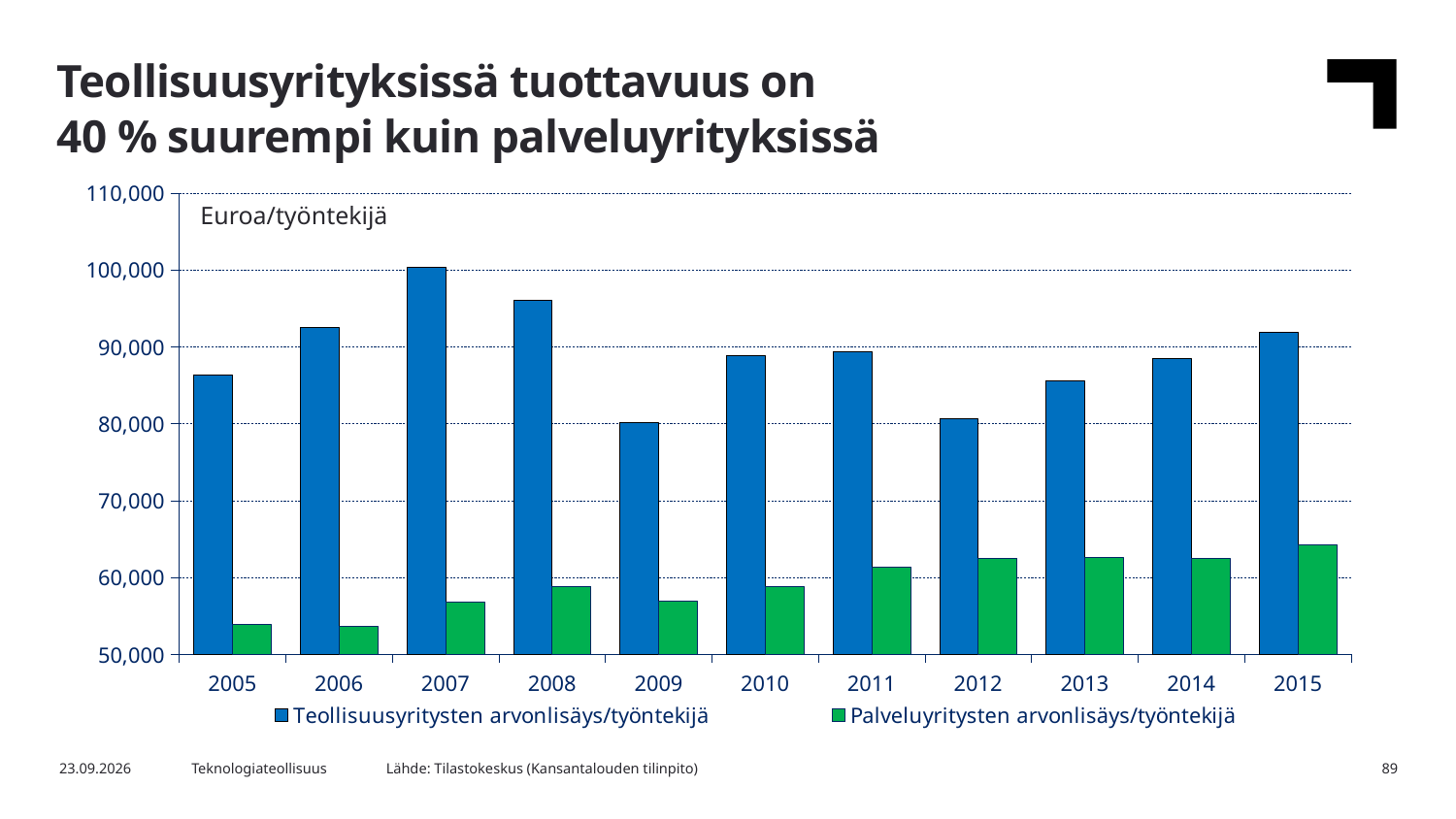
How many series does the legend list? 2 In which year is the value for Palveluyritysten arvonlisäys/työntekijä highest? 2015 What unit label is shown inside the chart area? Euroa/työntekijä Do the values for Palveluyritysten arvonlisäys/työntekijä generally rise or fall from 2005 to 2015? Rise How many years are shown on the x axis? 11 Is the value for Teollisuusyritysten arvonlisäys/työntekijä in 2009 greater or less than 90,000? less Is the value for Teollisuusyritysten arvonlisäys/työntekijä in 2008 greater or less than 90,000? greater What kind of chart is shown on the slide? Bar chart Which is larger: Teollisuusyritysten arvonlisäys/työntekijä in 2006 or in 2005? 2006 Is the value for Palveluyritysten arvonlisäys/työntekijä in 2015 greater or less than 60,000? greater In which year is the value for Teollisuusyritysten arvonlisäys/työntekijä highest? 2007